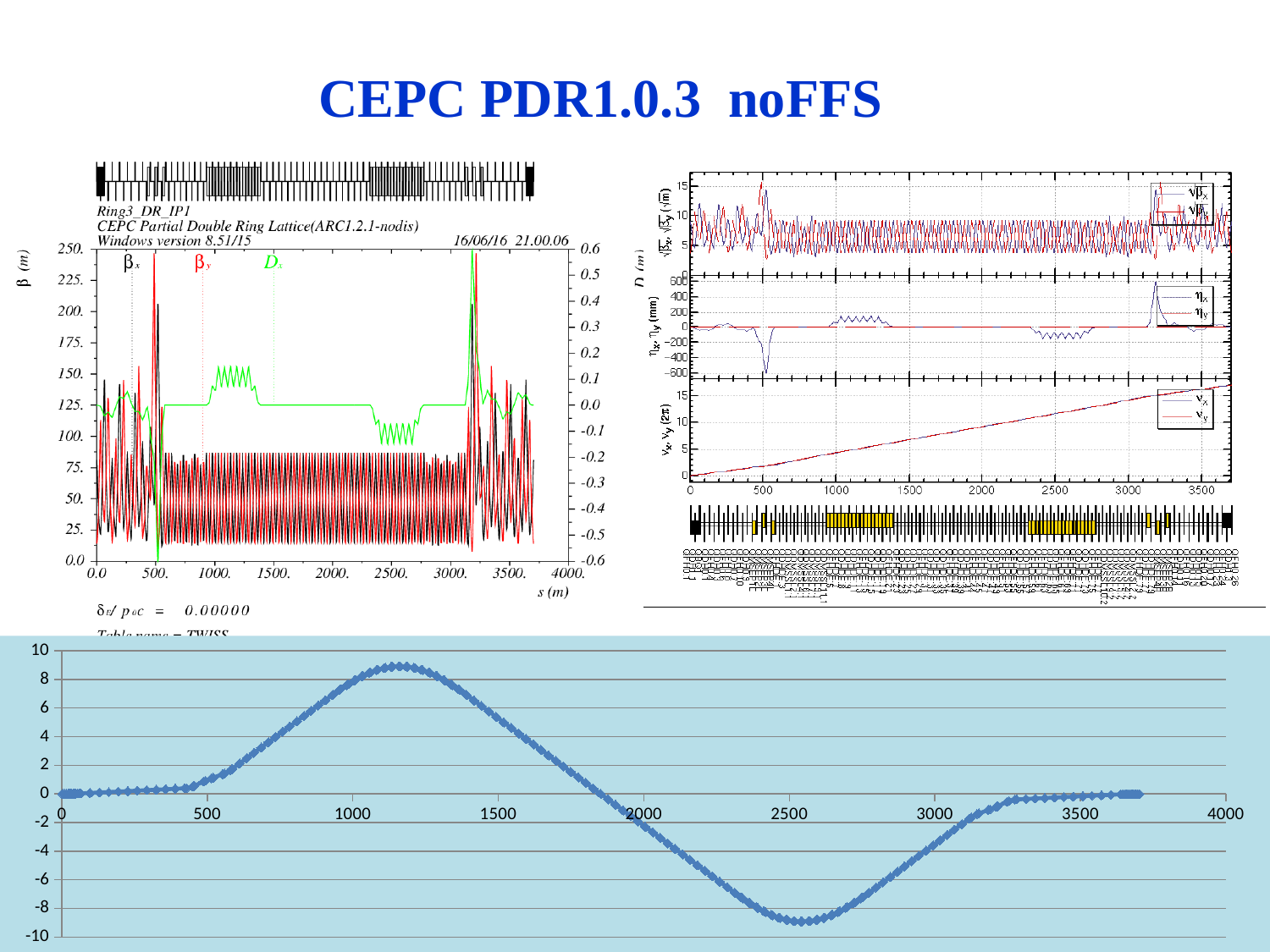
In the middle panel of the top-right chart, is the ηx value near s = 500 greater or less than -400? less What kind of chart is the bottom chart on the slide? line chart In the bottom chart, is the value at x = 2500 greater or less than -8? less In the bottom panel of the top-right chart, do the νx and νy curves rise or fall as s increases from 0 to 3500? rise In the top-left chart, how many series are listed in the legend? 3 In the bottom chart, what is the highest tick value shown on the y axis? 10 In the bottom chart, does the curve rise or fall between x = 500 and x = 1000? rise In the bottom chart, is the value at x = 1150 greater or less than 8? greater In the top-left chart, what is the label of the x axis? s (m) In the bottom chart, does the curve rise or fall between x = 1500 and x = 2500? fall In the top-left chart, what is the maximum value shown on the left y axis (β)? 250.